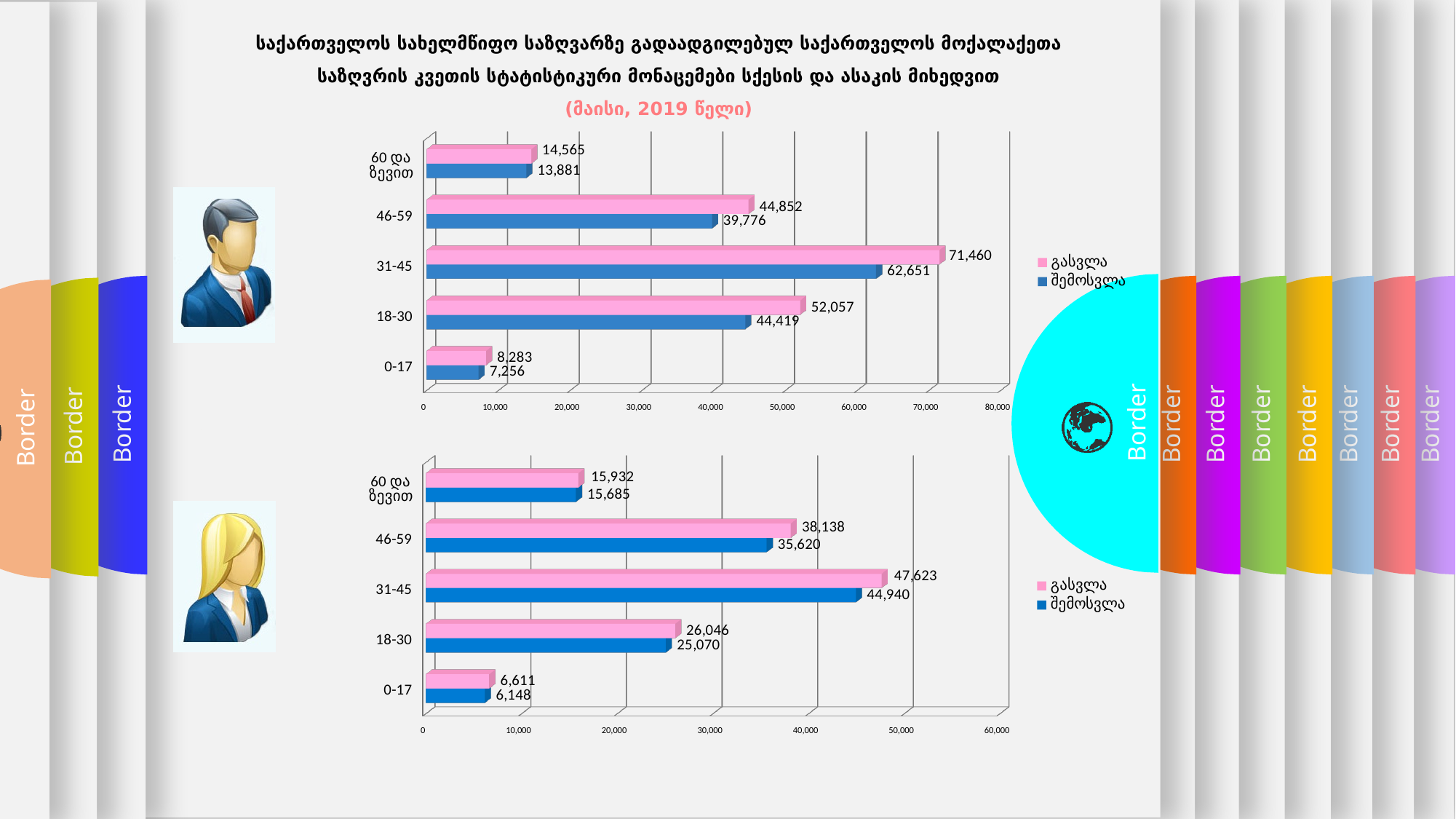
In the bottom chart, what is the შემოსვლა value for the 0-17 age group? 6,148 In the top chart, what is the difference between the გასვლა and შემოსვლა values for the 46-59 age group? 5,076 In the top chart, what is the შემოსვლა value for the 18-30 age group? 44,419 In the bottom chart, what is the difference between the გასვლა values for the 31-45 and 18-30 age groups? 21,577 What type of chart is the bottom chart? Bar chart In the bottom chart, which age group has the lowest შემოსვლა value? 0-17 How many series does the legend of the top chart list? 2 In the top chart, which age group has the highest გასვლა value? 31-45 In the top chart, which is larger: the შემოსვლა value for 46-59 or the შემოსვლა value for 18-30? 18-30 In the top chart, what is the გასვლა value for the 31-45 age group? 71,460 In the bottom chart, what is the გასვლა value for the 46-59 age group? 38,138 How many age groups are shown in the bottom chart? 5